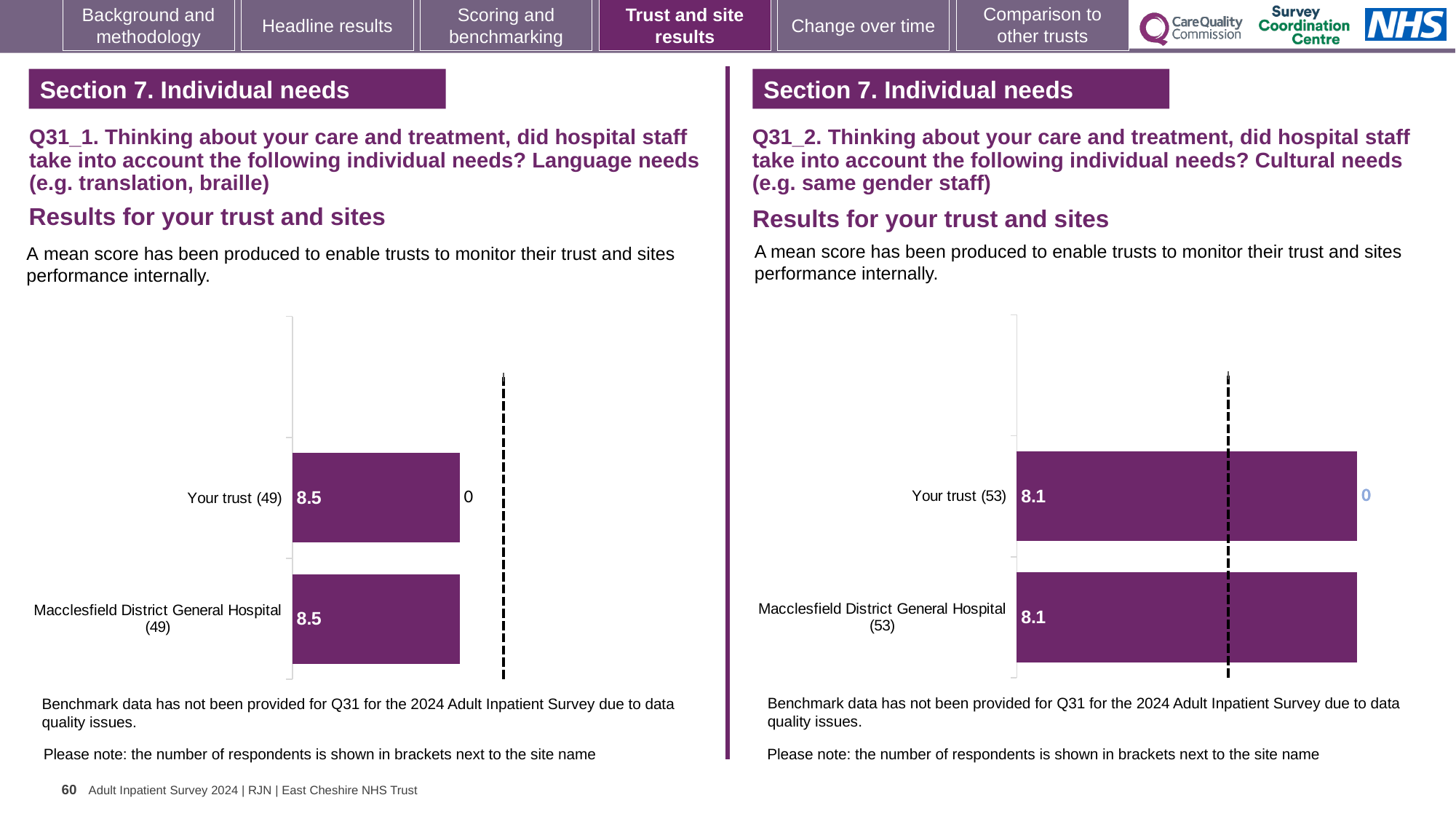
In the left chart (Q31_1, Language needs), how many respondents are shown in brackets for Your trust? 49 Is the score for Your trust in the right chart (Q31_2, Cultural needs) higher or lower than the score for Your trust in the left chart (Q31_1, Language needs)? Lower How many bars are plotted in the right chart (Q31_2, Cultural needs)? 2 In the right chart (Q31_2, Cultural needs), what is the difference between the score for Your trust and the score for Macclesfield District General Hospital? 0 In the right chart (Q31_2, Cultural needs), how many respondents are shown in brackets for Macclesfield District General Hospital? 53 In the left chart (Q31_1, Language needs), what is the mean score for Your trust? 8.5 In the left chart (Q31_1, Language needs), what is the difference between the score for Your trust and the score for Macclesfield District General Hospital? 0 What type of chart is used on the left side of the slide (Q31_1, Language needs)? Bar chart How many bars are plotted in the left chart (Q31_1, Language needs)? 2 In the right chart (Q31_2, Cultural needs), what is the mean score for Macclesfield District General Hospital? 8.1 In the left chart (Q31_1, Language needs), what is the mean score for Macclesfield District General Hospital? 8.5 In the right chart (Q31_2, Cultural needs), what is the mean score for Your trust? 8.1